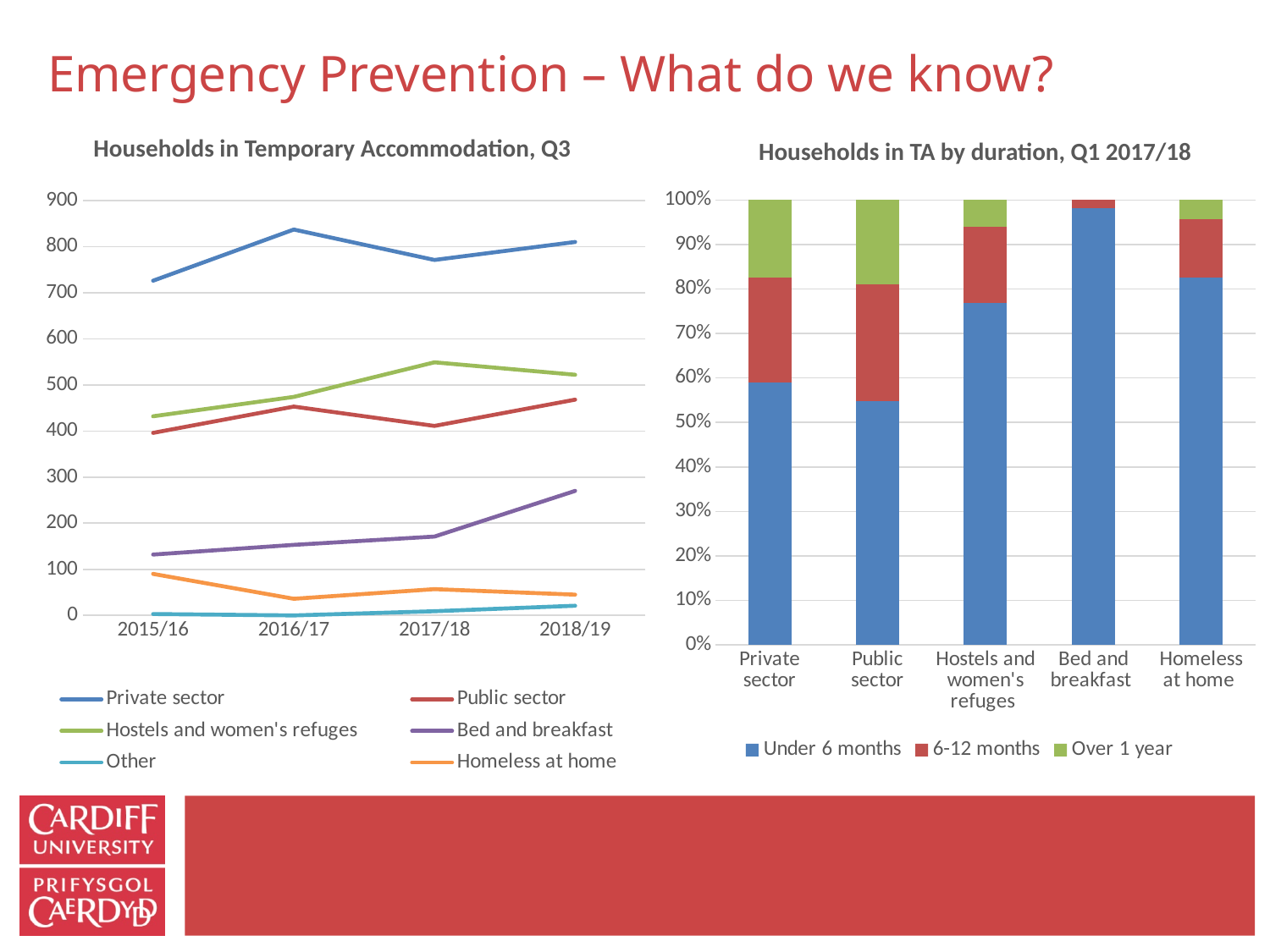
What kind of chart is 'Households in TA by duration, Q1 2017/18'? stacked bar chart In 'Households in TA by duration, Q1 2017/18', is the Under 6 months share for Private sector greater or less than 50%? greater In 'Households in Temporary Accommodation, Q3', is the Private sector value for 2015/16 greater or less than 700? greater In 'Households in Temporary Accommodation, Q3', does the Bed and breakfast series rise or fall from 2015/16 to 2018/19? rise What kind of chart is 'Households in Temporary Accommodation, Q3'? line chart In 'Households in Temporary Accommodation, Q3', how many series does the legend list? 6 In 'Households in Temporary Accommodation, Q3', which series has the lowest values across all years? Other In 'Households in Temporary Accommodation, Q3', which series has the highest values across all years? Private sector In 'Households in Temporary Accommodation, Q3', how many years are shown on the x axis? 4 In 'Households in TA by duration, Q1 2017/18', which category has the largest Under 6 months share? Bed and breakfast In 'Households in TA by duration, Q1 2017/18', how many categories are shown on the x axis? 5